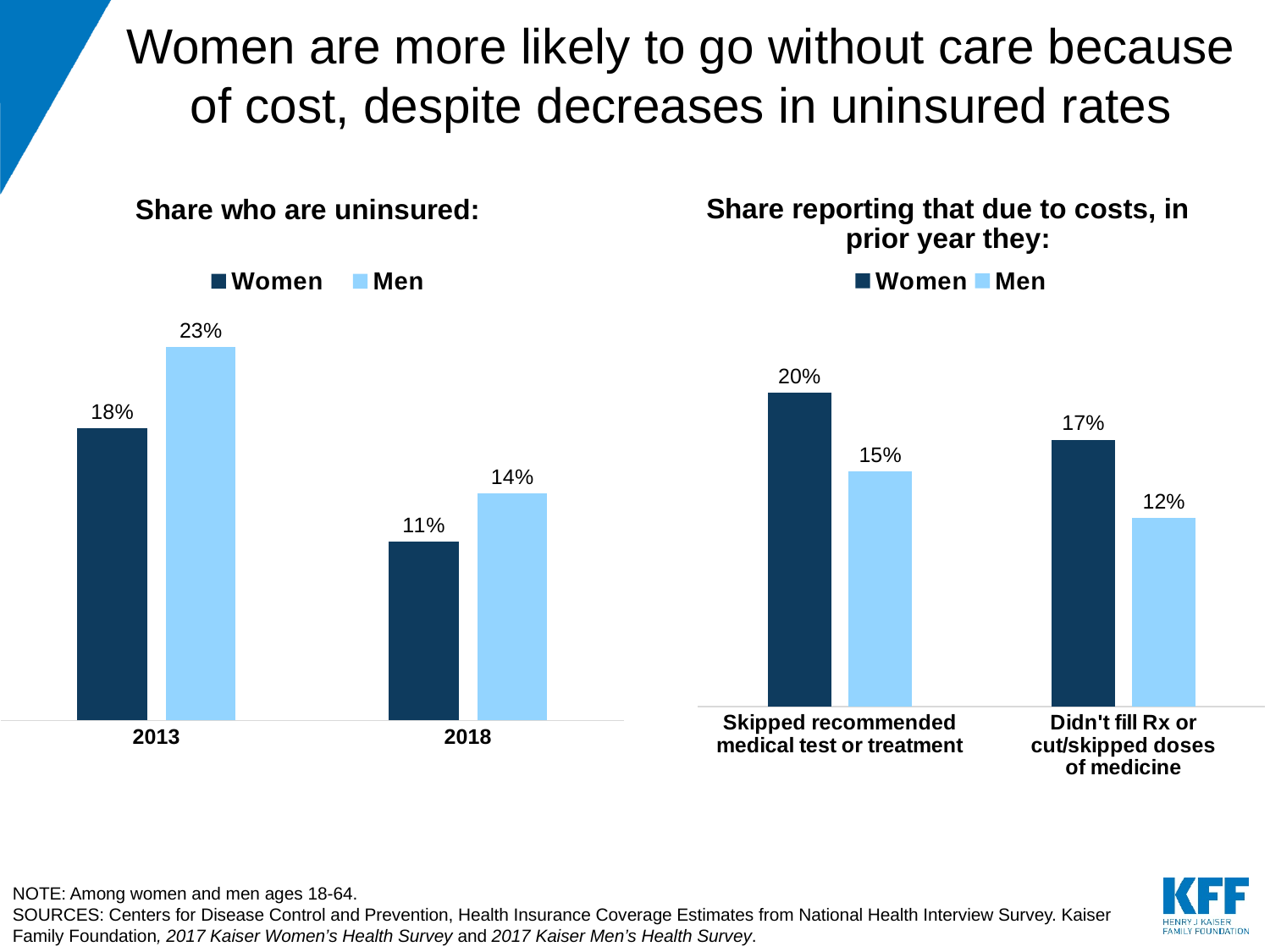
In the 'Share reporting that due to costs, in prior year they' chart, what is the value for Men who didn't fill Rx or cut/skipped doses of medicine? 12% In the 'Share who are uninsured' chart, what is the value for Men in 2018? 14% In the 'Share who are uninsured' chart, how many series does the legend list? 2 In the 'Share reporting that due to costs, in prior year they' chart, what is the value for Women who skipped recommended medical test or treatment? 20% What kind of chart is the 'Share who are uninsured' chart? bar chart In the 'Share reporting that due to costs, in prior year they' chart, how many categories are shown on the x axis? 2 In the 'Share reporting that due to costs, in prior year they' chart, what is the difference between Women and Men for 'Didn't fill Rx or cut/skipped doses of medicine'? 5% In the 'Share reporting that due to costs, in prior year they' chart, which category has the highest value for Women? Skipped recommended medical test or treatment In the 'Share who are uninsured' chart, does the Women value rise or fall from 2013 to 2018? fall In the 'Share who are uninsured' chart, what is the value for Women in 2013? 18% In the 'Share who are uninsured' chart, which series has the higher value in 2018, Women or Men? Men In the 'Share who are uninsured' chart, what is the difference between the Men and Women values in 2013? 5%